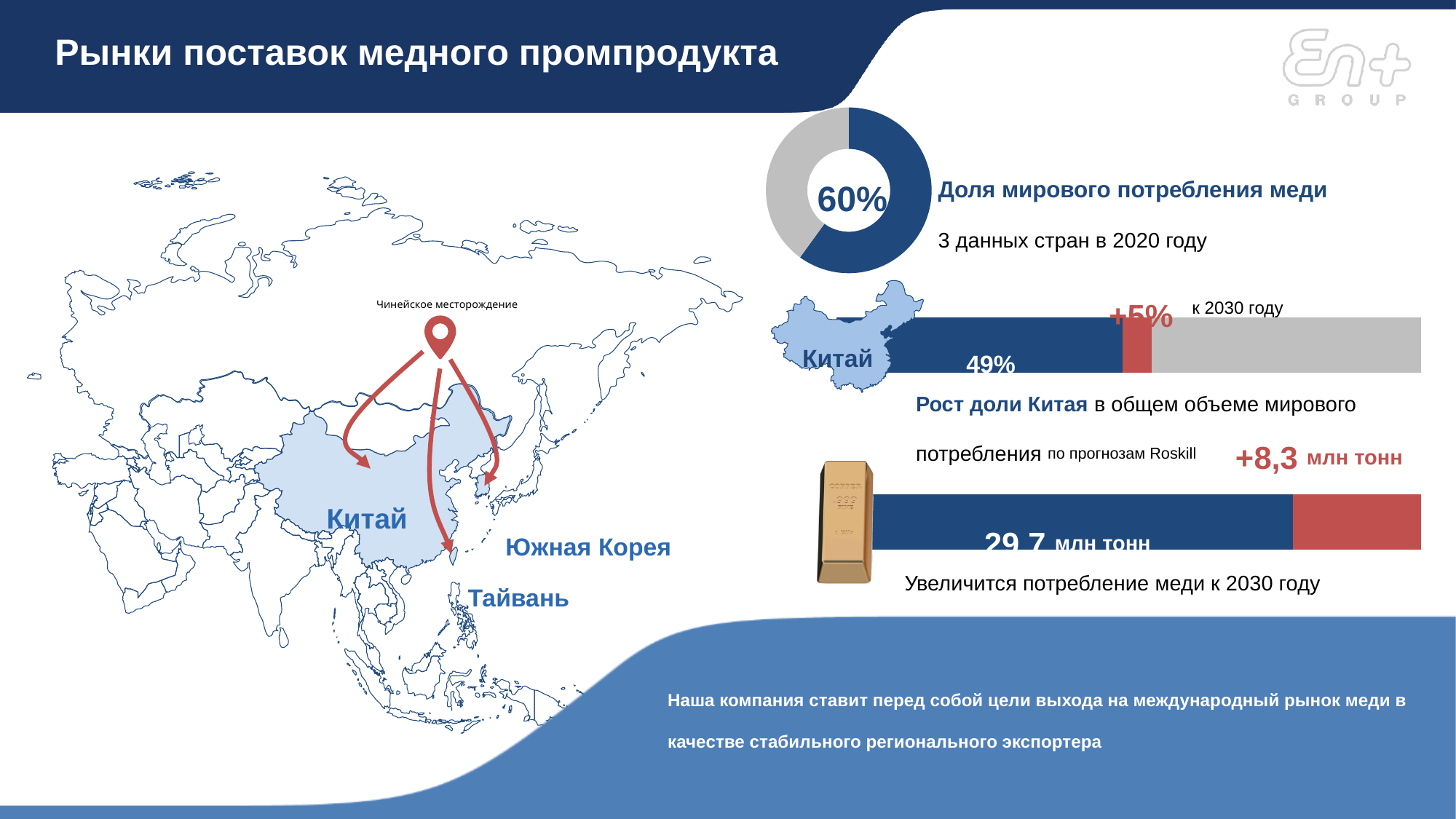
On the bottom-right bar next to the copper ingot, by how much is copper consumption expected to increase by 2030? +8,3 млн тонн On the bottom-right bar next to the copper ingot, what is the current copper consumption shown in the blue segment? 29,7 млн тонн On the horizontal bar next to the map of China, what is China's current share of world copper consumption? 49% On the donut chart at the top right, what share of the circle is left for the grey (remaining) portion? 40% What kind of chart is used at the top right to show the 60% share of world copper consumption? Donut (pie) chart On the horizontal bar next to the map of China, by how much is China's share forecast to grow by 2030? +5% On the horizontal bar next to the map of China, what is China's total share of world copper consumption forecast for 2030 (blue plus red segments)? 54% On the horizontal bar next to the map of China, what colour is the segment representing the +5% growth? Red On the donut chart at the top right, what share of world copper consumption do the three countries account for in 2020? 60% On the bottom-right bar next to the copper ingot, what is the total copper consumption expected by 2030 (blue plus red segments)? 38,0 млн тонн On the bottom-right bar next to the copper ingot, which segment is larger: the blue segment (29,7 млн тонн) or the red segment (+8,3 млн тонн)? Blue segment On the donut chart at the top right, which portion is larger: the dark blue slice or the grey slice? Dark blue slice